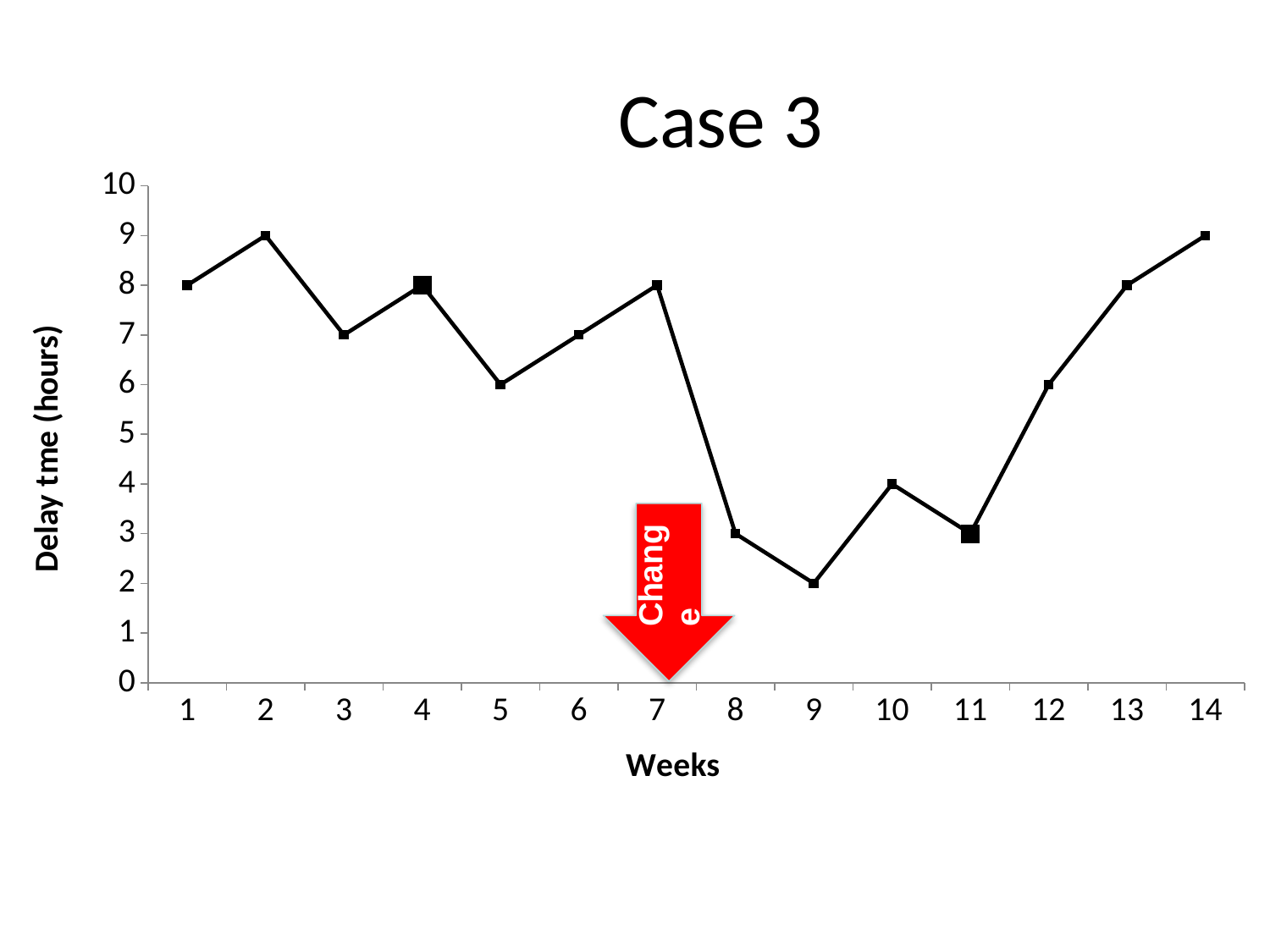
What is the difference in delay time between week 7 and week 8? 5 What is the delay time in week 9? 2 Does the delay time rise or fall from week 9 to week 14? rise How many weeks are plotted on the x axis? 14 What is the delay time in week 8? 3 What is the delay time in week 12? 6 What is the label of the y axis? Delay tme (hours) In which week is the delay time lowest? 9 What is the delay time in week 2? 9 Is the delay time in week 13 greater or less than 5? greater What type of chart is shown on the slide? line chart Which week has a larger delay time, week 5 or week 10? week 5